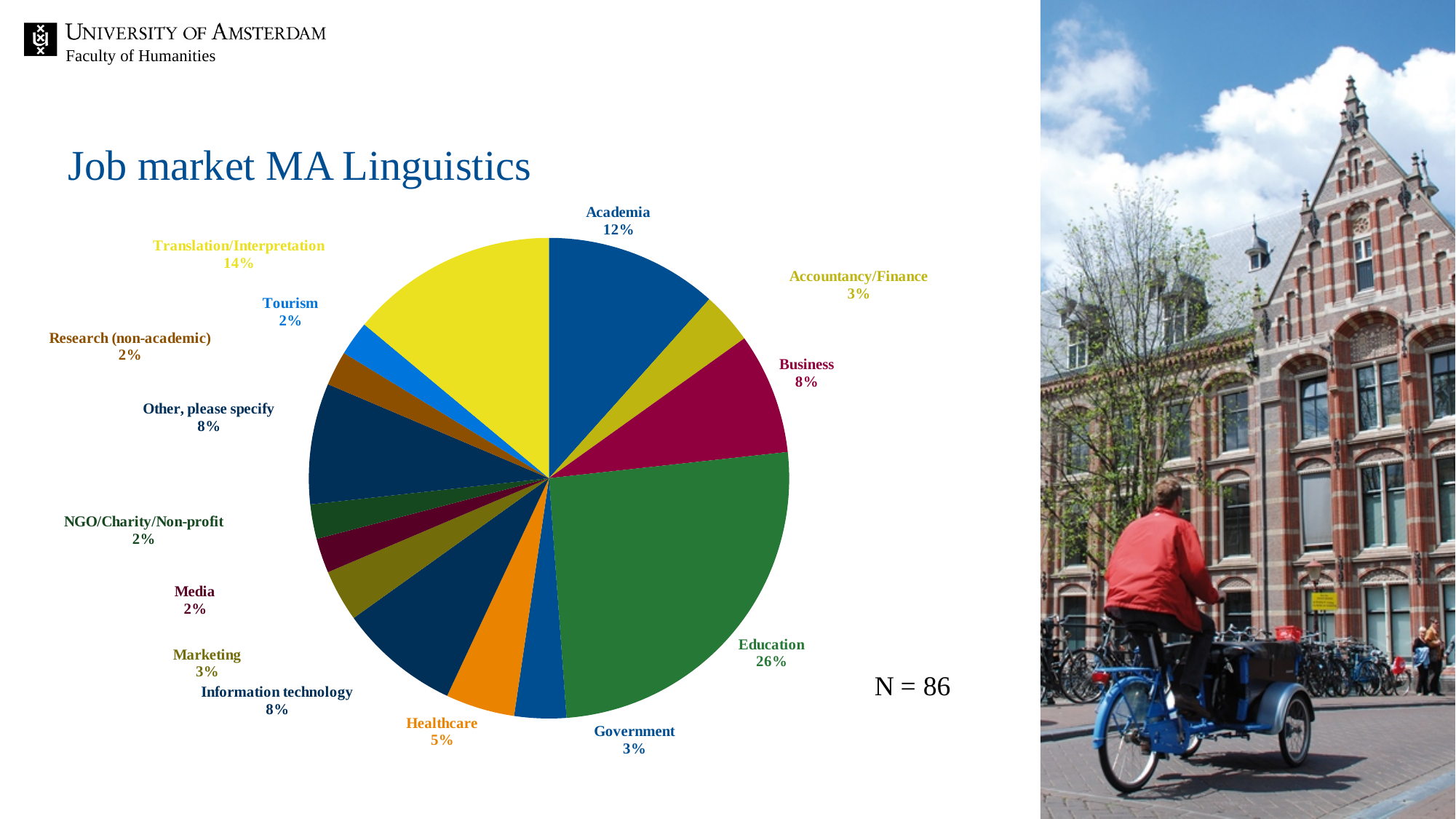
What type of chart is shown on the slide? Pie chart Which is larger, Business or Healthcare? Business What percentage of the pie is Education? 26% What is the difference between the Education and Academia percentages? 14% How many categories are shown in the pie chart? 14 What is the value shown for Healthcare? 5% What share does Translation/Interpretation have in the pie chart? 14% What is the value shown for Academia? 12% What sample size (N) is stated next to the pie chart? N = 86 What is the value shown for Information technology? 8% What is the title of the chart on the slide? Job market MA Linguistics Which category has the largest slice of the pie? Education